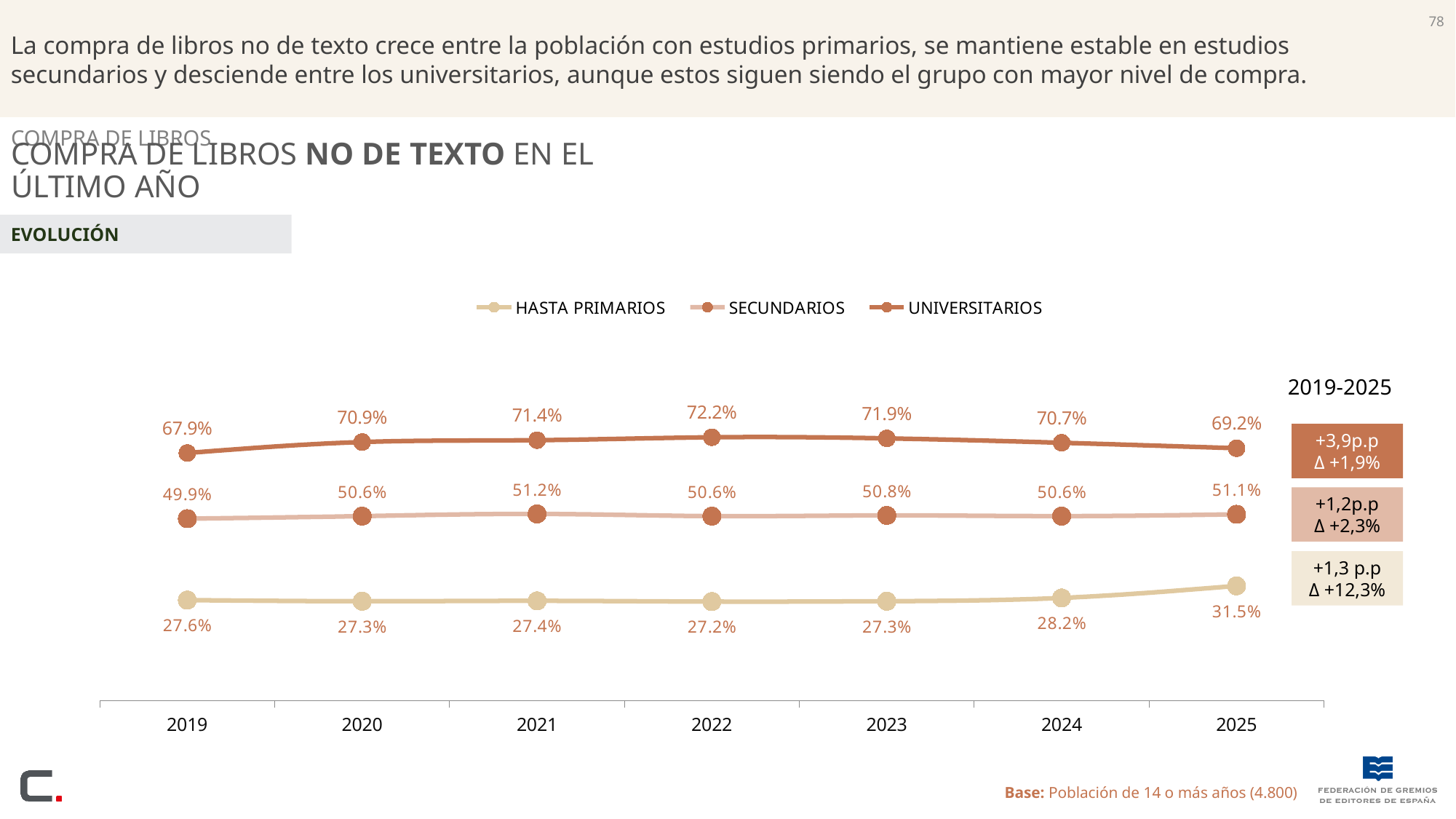
How many years are shown on the x axis? 7 What kind of chart is shown on the slide? Line chart How many series does the legend list? 3 Which series is drawn in the lightest (beige) colour? HASTA PRIMARIOS Does the HASTA PRIMARIOS series rise or fall between 2024 and 2025? Rise In which year does the UNIVERSITARIOS series reach its highest value? 2022 What is the value for UNIVERSITARIOS in 2022? 72.2% In which year does the UNIVERSITARIOS series have its lowest value? 2019 What is the value for HASTA PRIMARIOS in 2025? 31.5% What is the difference between the UNIVERSITARIOS and SECUNDARIOS values in 2025? 18.1 percentage points What is the value for SECUNDARIOS in 2019? 49.9% Which series has the highest value in 2023: HASTA PRIMARIOS or SECUNDARIOS? SECUNDARIOS